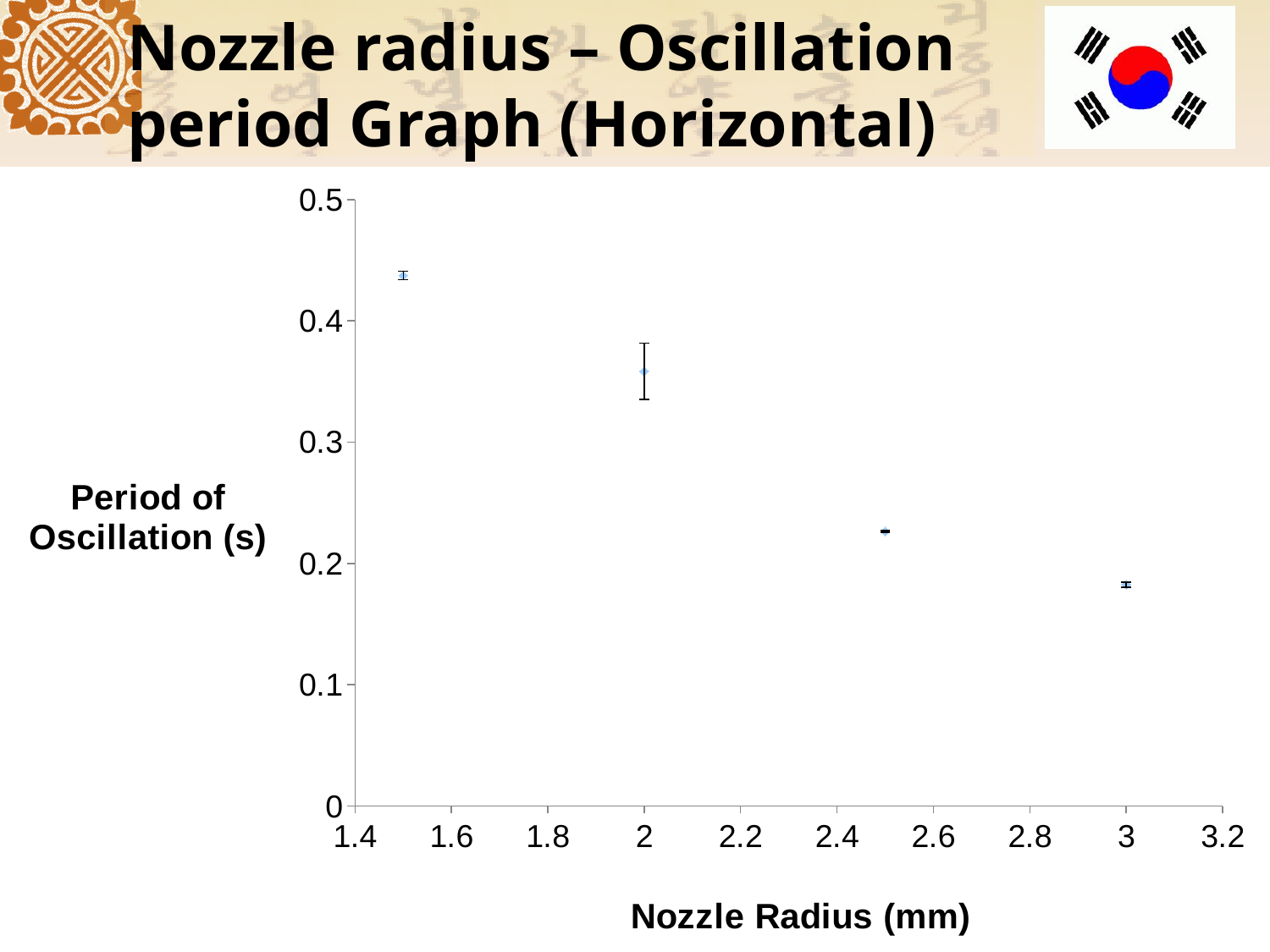
What is the label of the y axis? Period of Oscillation (s) Does the period of oscillation rise or fall as the nozzle radius increases? fall At which nozzle radius is the period of oscillation highest? 1.5 At which nozzle radius is the period of oscillation lowest? 3 Is the period of oscillation at a nozzle radius of 2 mm greater or less than 0.4 s? less How many data points are plotted on the chart? 4 What kind of chart is shown on the slide? scatter chart Which has a larger period of oscillation: a nozzle radius of 2 mm or 2.5 mm? 2 mm Is the period of oscillation at a nozzle radius of 3 mm greater or less than 0.2 s? less Is the period of oscillation at a nozzle radius of 1.5 mm greater or less than 0.4 s? greater What is the label of the x axis? Nozzle Radius (mm)